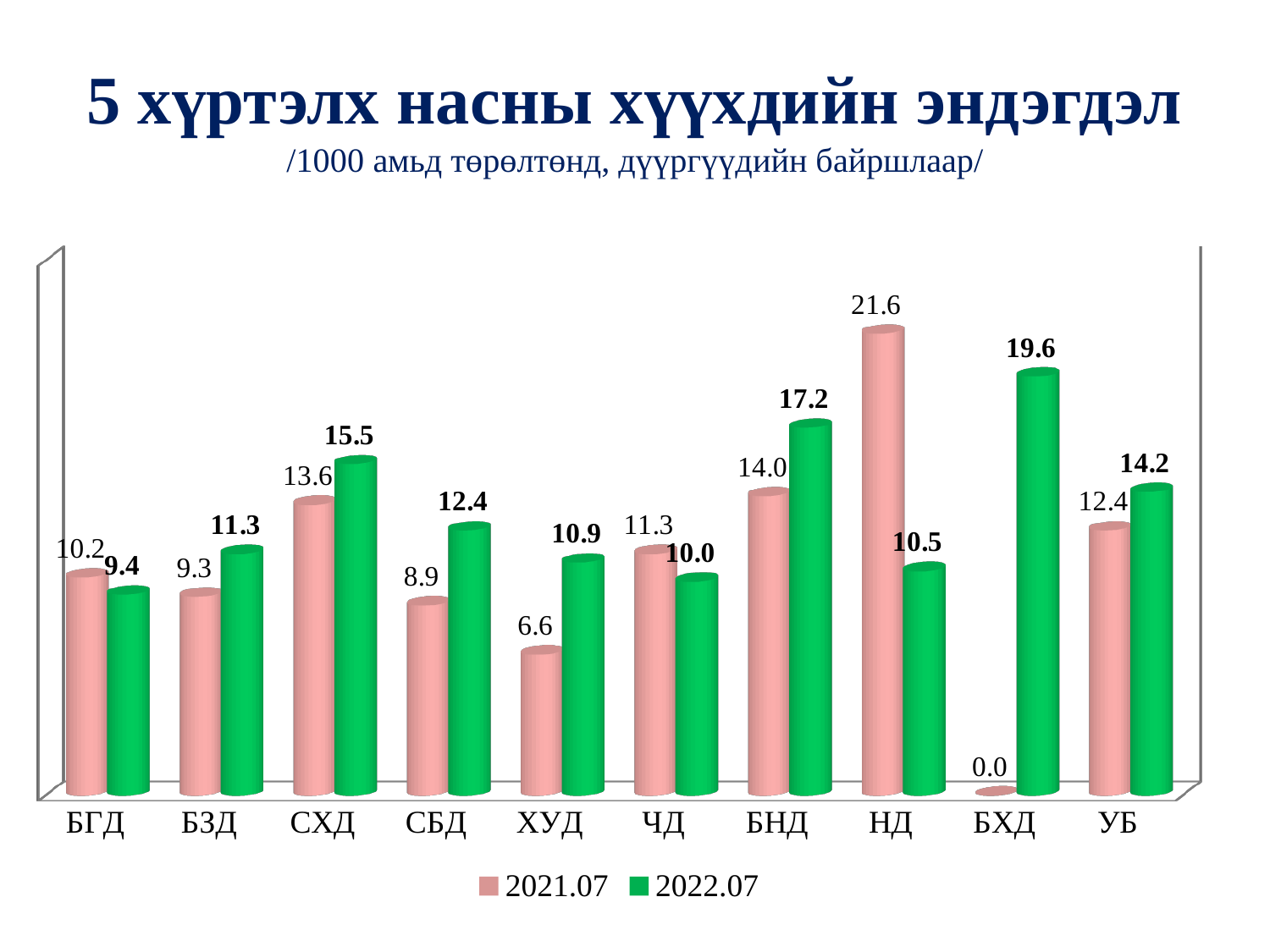
What kind of chart is shown on the slide? Bar chart What is the difference between the 2022.07 and 2021.07 values for БХД? 19.6 For СХД, which is larger: the 2021.07 value or the 2022.07 value? 2022.07 How many series does the legend list? 2 What is the difference between the 2021.07 and 2022.07 values for НД? 11.1 Which district has the highest 2021.07 value? НД What is the 2022.07 value for БХД? 19.6 Which district has the lowest 2022.07 value? БГД Which district has the lowest 2021.07 value? БХД What is the 2022.07 value for ХУД? 10.9 What is the 2021.07 value for НД? 21.6 How many districts (categories) are shown on the x axis? 10